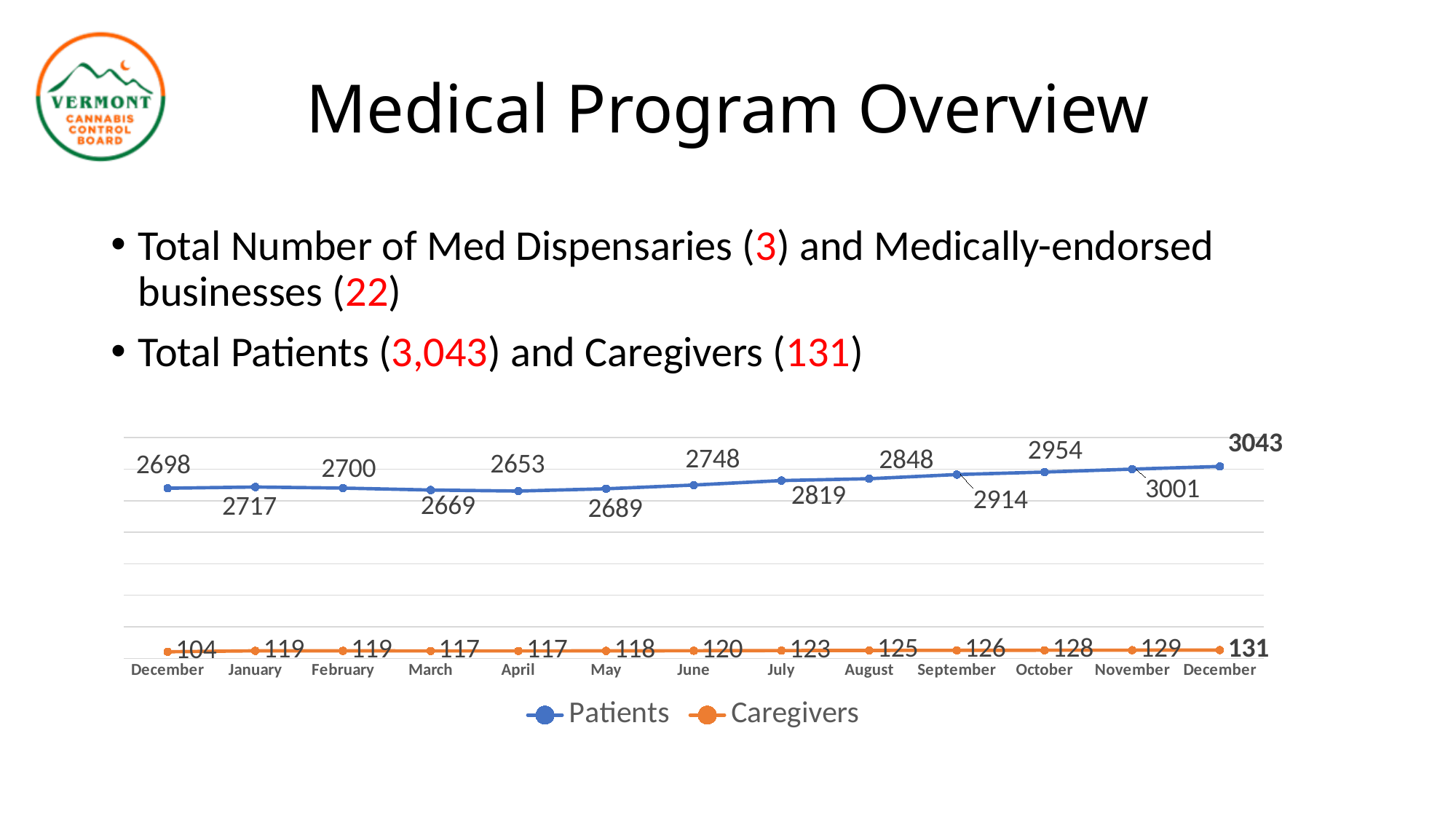
Which is larger, the Patients value in June or in May? June What is the Patients value for the final December on the x axis? 3043 What is the difference between the Patients value in the final December and the first December? 345 How many series does the chart legend list? 2 In which month is the Caregivers value lowest? the first December What is the Patients value for July? 2819 What is the Caregivers value for March? 117 What type of chart is shown on the slide? line chart Do the Patients values generally rise or fall from April to the final December? rise How many data points are plotted for the Patients series? 13 What is the difference between the Caregivers values in November and October? 1 In which month is the Patients value lowest? April